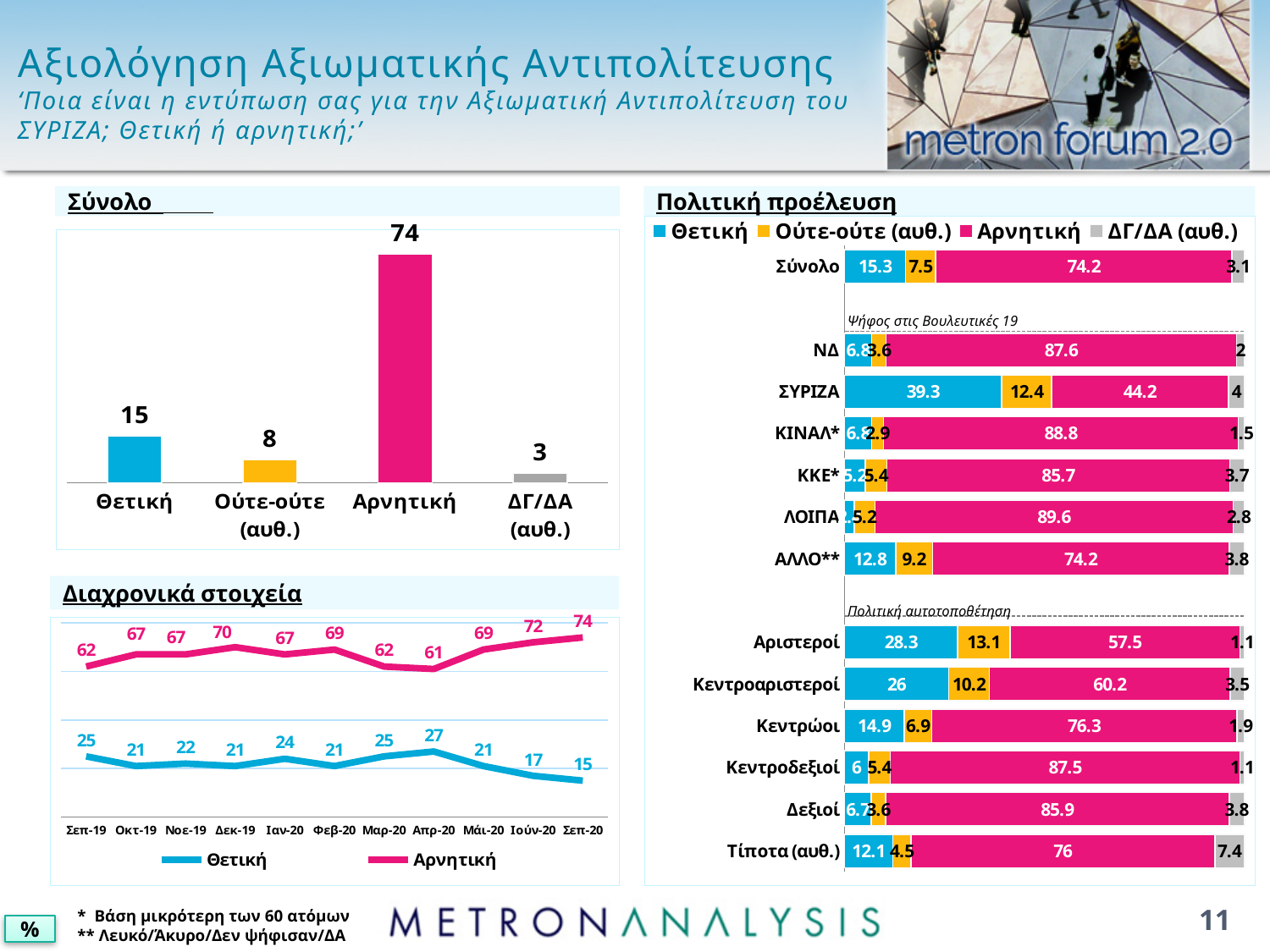
In the "Σύνολο" chart, what is the value for Αρνητική? 74 In the "Διαχρονικά στοιχεία" chart, does the Θετική series rise or fall from Απρ-20 to Σεπ-20? fall In the "Πολιτική προέλευση" chart, which category has the highest Θετική value? ΣΥΡΙΖΑ In the "Σύνολο" chart, how many categories are shown? 4 In the "Διαχρονικά στοιχεία" chart, what is the value of Αρνητική for Απρ-20? 61 What kind of chart is the "Διαχρονικά στοιχεία" chart? line chart In the "Σύνολο" chart, which category has the lowest value? ΔΓ/ΔΑ (αυθ.) In the "Διαχρονικά στοιχεία" chart, how many series does the legend list? 2 In the "Πολιτική προέλευση" chart, which is larger: the Αρνητική value for Αριστεροί or for Κεντροαριστεροί? Κεντροαριστεροί In the "Πολιτική προέλευση" chart, what is the Αρνητική value for ΣΥΡΙΖΑ? 44.2 In the "Σύνολο" chart, what is the difference between the values for Αρνητική and Θετική? 59 In the "Πολιτική προέλευση" chart, how many series does the legend list? 4